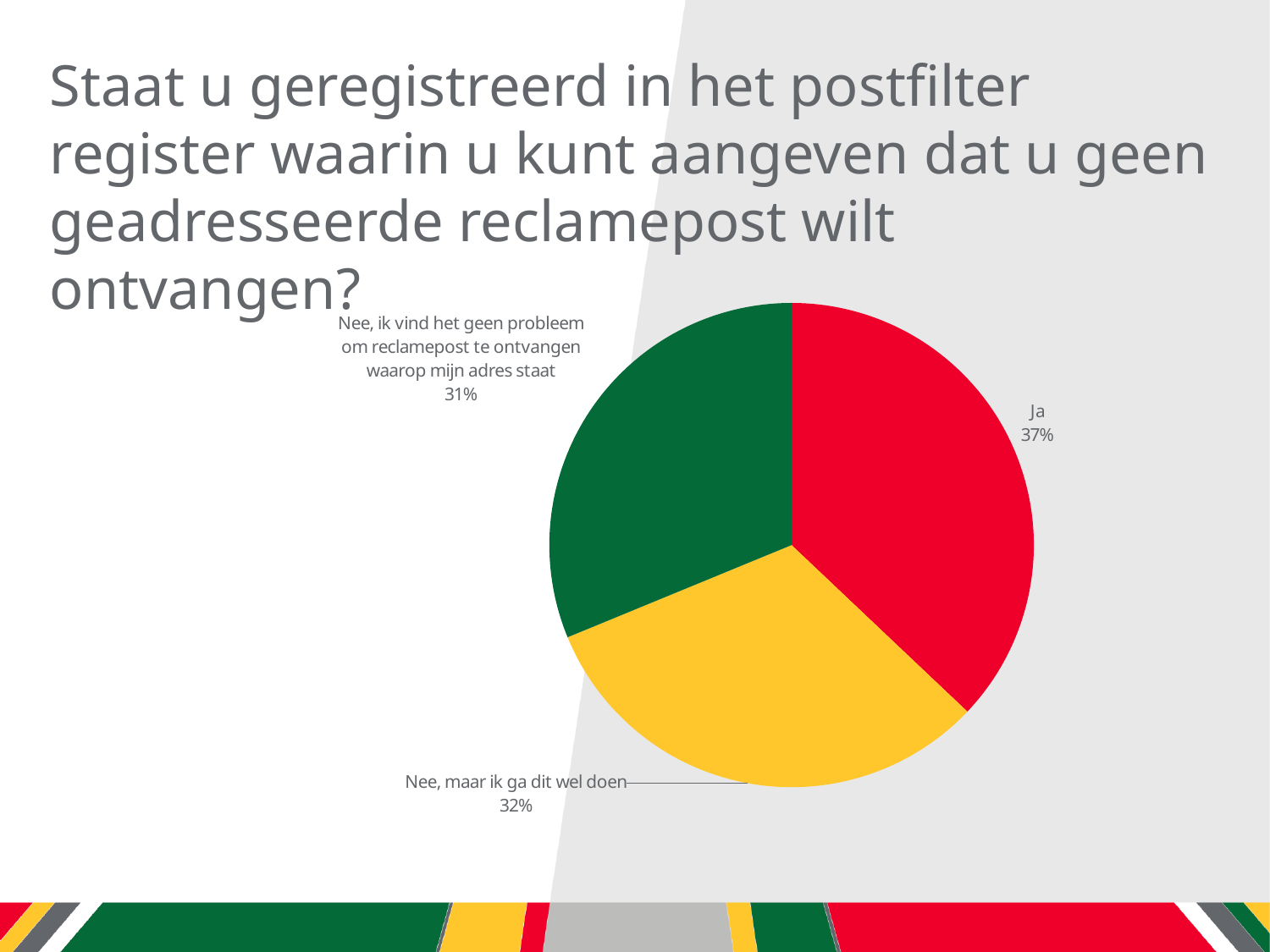
What colour is the slice for "Nee, maar ik ga dit wel doen"? yellow Which is larger: the share for "Ja" or the share for "Nee, maar ik ga dit wel doen"? Ja What is the difference in percentage points between "Ja" and "Nee, ik vind het geen probleem om reclamepost te ontvangen waarop mijn adres staat"? 6 Which answer has the largest share of the pie? Ja What percentage of respondents answered "Nee, ik vind het geen probleem om reclamepost te ontvangen waarop mijn adres staat"? 31% Which answer has the smallest share of the pie? Nee, ik vind het geen probleem om reclamepost te ontvangen waarop mijn adres staat What percentage of respondents answered "Nee, maar ik ga dit wel doen"? 32% What kind of chart is shown on the slide? pie chart How many slices does the pie chart have? 3 What is the difference in percentage points between "Ja" and "Nee, maar ik ga dit wel doen"? 5 What colour is the slice for "Ja"? red What percentage of respondents answered "Ja"? 37%